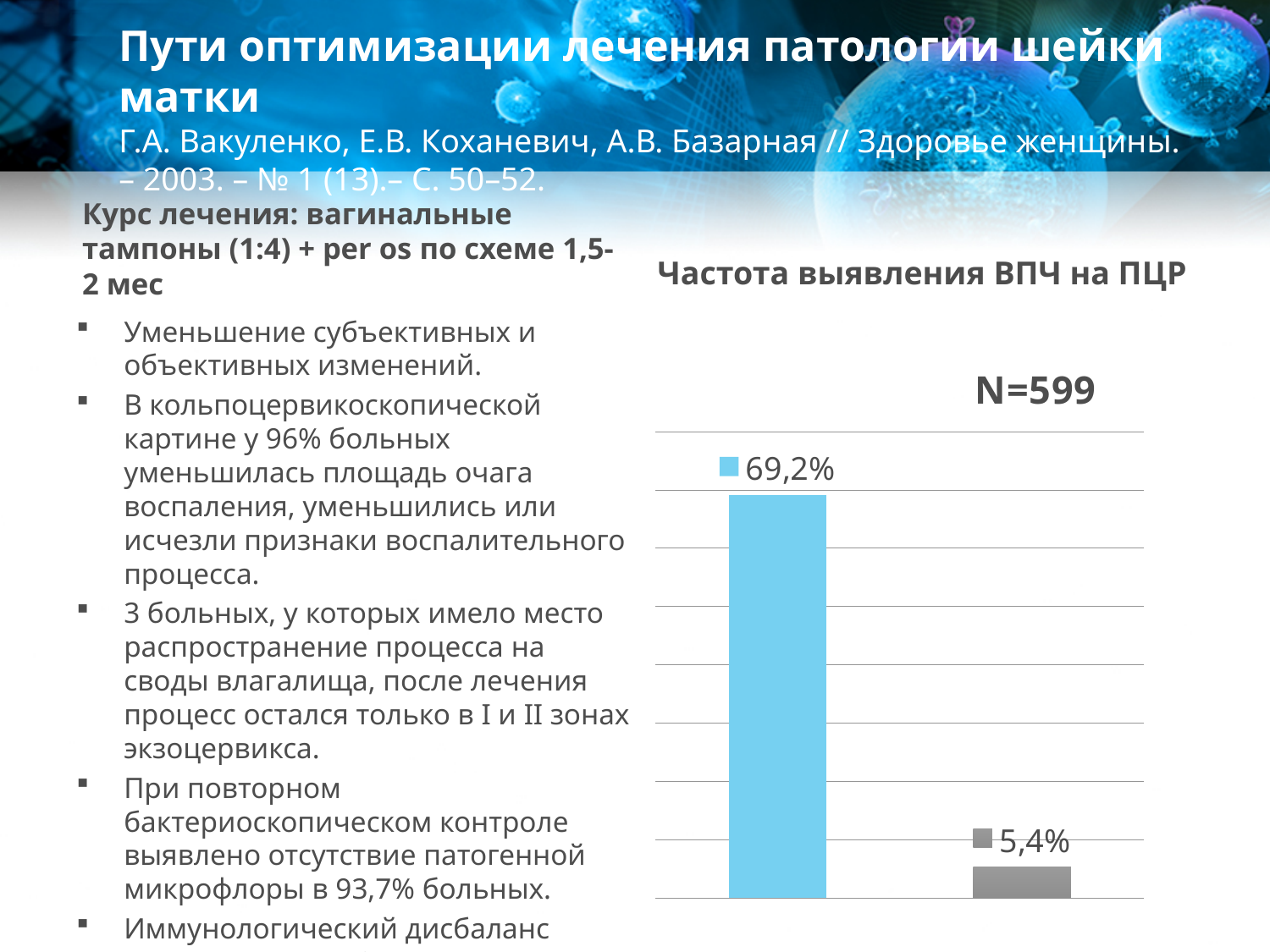
What sample size (N) is stated on the chart? N=599 Do the values in the chart rise or fall from left to right? fall Which bar in the chart has the highest value? the blue bar (69,2%) Which is larger in the chart: the blue bar or the gray bar? the blue bar How many bars are plotted in the chart? 2 What type of chart is shown on the slide? bar chart What is the difference between the blue bar value and the gray bar value in the chart? 63,8% Which bar in the chart has the lowest value? the gray bar (5,4%) What is the title of the chart on the slide? Частота выявления ВПЧ на ПЦР What value is shown for the blue bar in the chart? 69,2% What value is shown for the gray bar in the chart? 5,4%